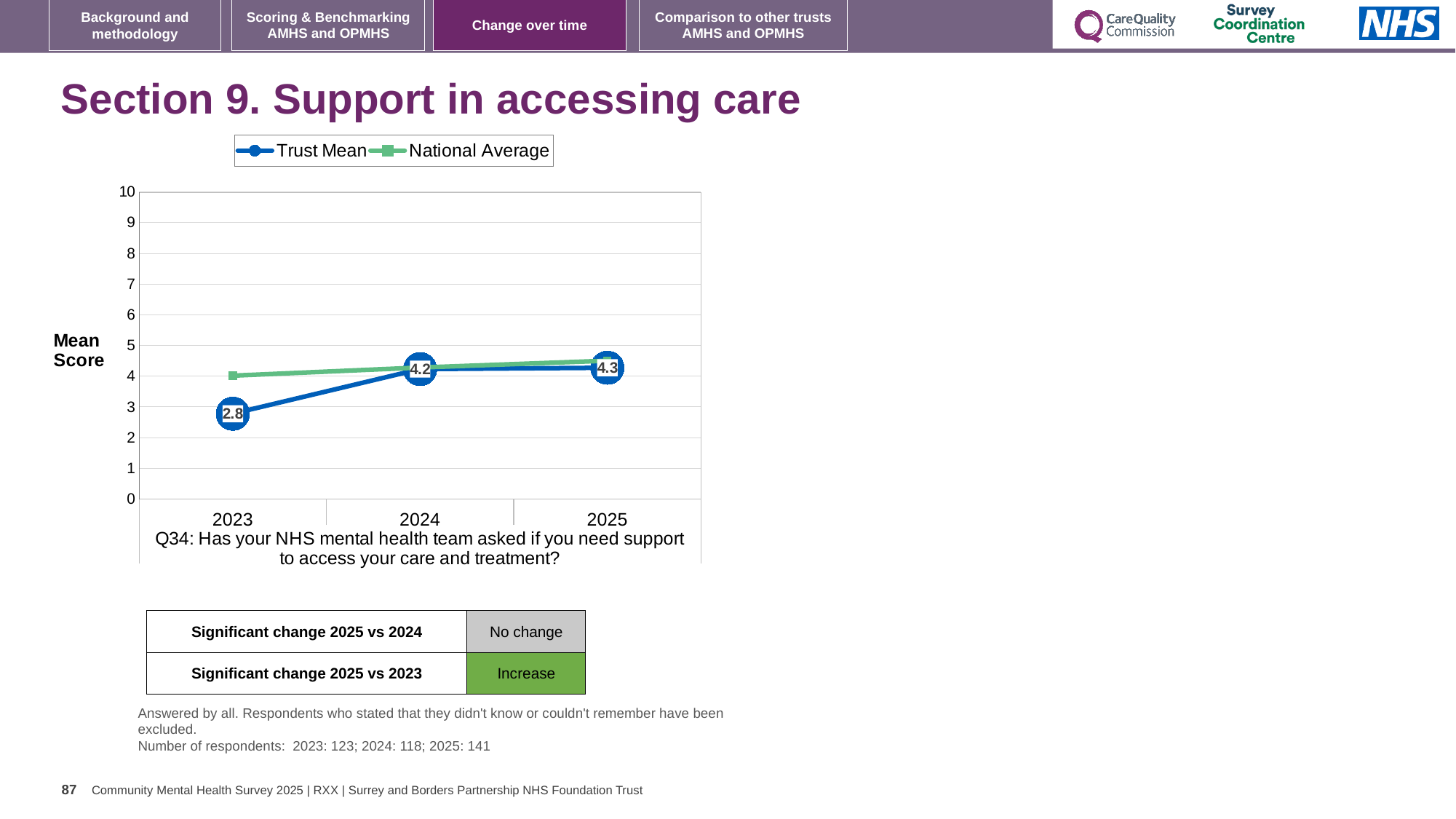
What is the Trust Mean value for 2025? 4.3 What is the Trust Mean value for 2023? 2.8 In which year is the Trust Mean lowest? 2023 In which year is the Trust Mean highest? 2025 Is the National Average value for 2023 greater or less than 3? greater What kind of chart is shown on the slide? Line chart Which is larger, the Trust Mean in 2023 or in 2024? 2024 What is the Trust Mean value for 2024? 4.2 How many years are plotted on the x axis? 3 How many series does the legend list? 2 What is the difference between the Trust Mean in 2025 and in 2023? 1.5 Is the National Average value for 2025 greater or less than 6? less